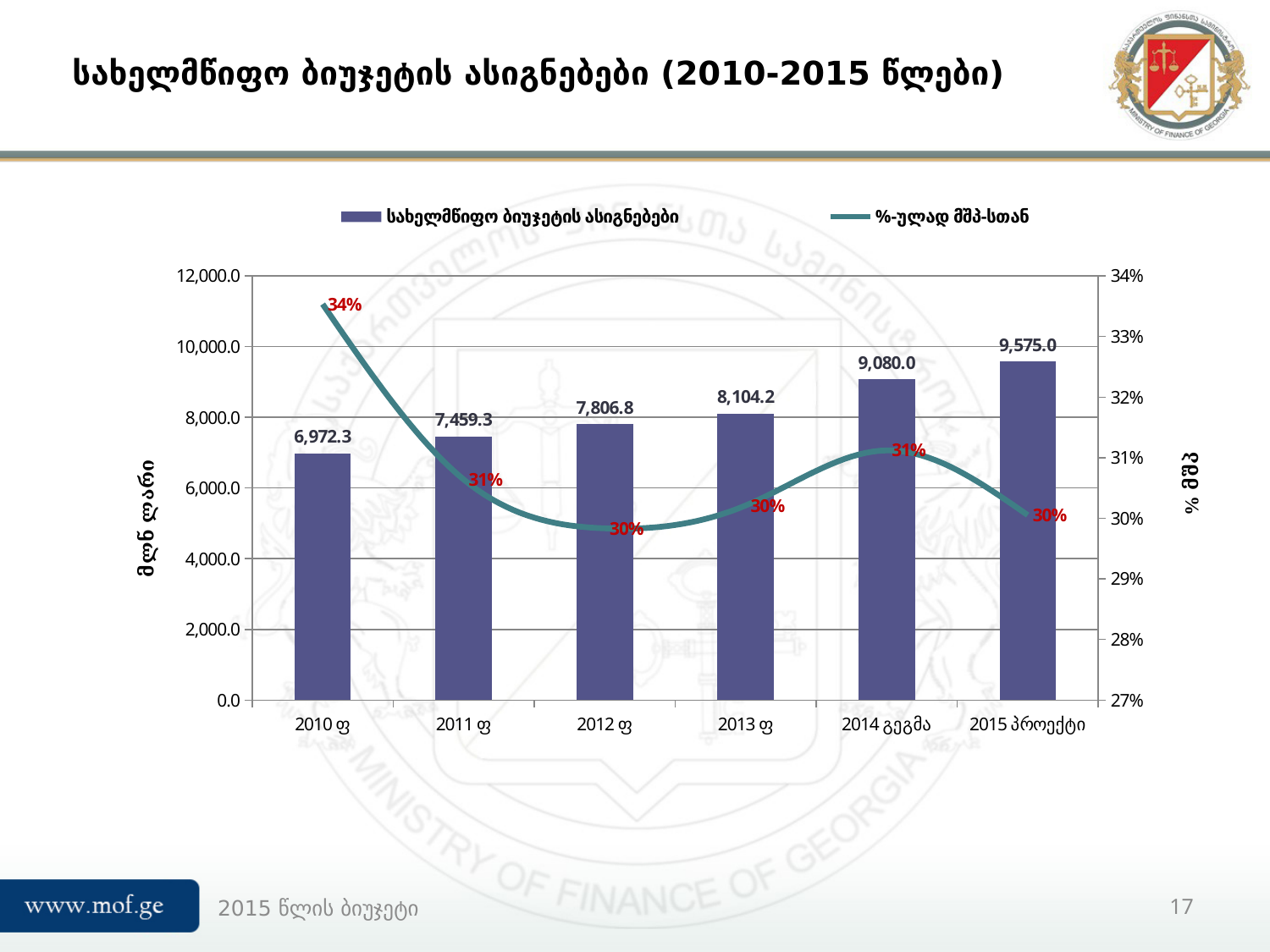
How many series does the legend list? 2 Do the bar values rise or fall from 2010 ფ to 2015 პროექტი? rise What is the value of the bar for 2015 პროექტი? 9,575.0 Which category has the highest bar value? 2015 პროექტი What is the difference between the bar values for 2015 პროექტი and 2014 გეგმა? 495.0 What is the value of the bar for 2014 გეგმა? 9,080.0 How many categories are shown on the x axis? 6 Which is larger, the bar value for 2012 ფ or for 2013 ფ? 2013 ფ What is the value of the bar for 2010 ფ? 6,972.3 What percentage does the line series show for 2010 ფ? 34% Which category has the lowest bar value? 2010 ფ What percentage does the line series show for 2014 გეგმა? 31%